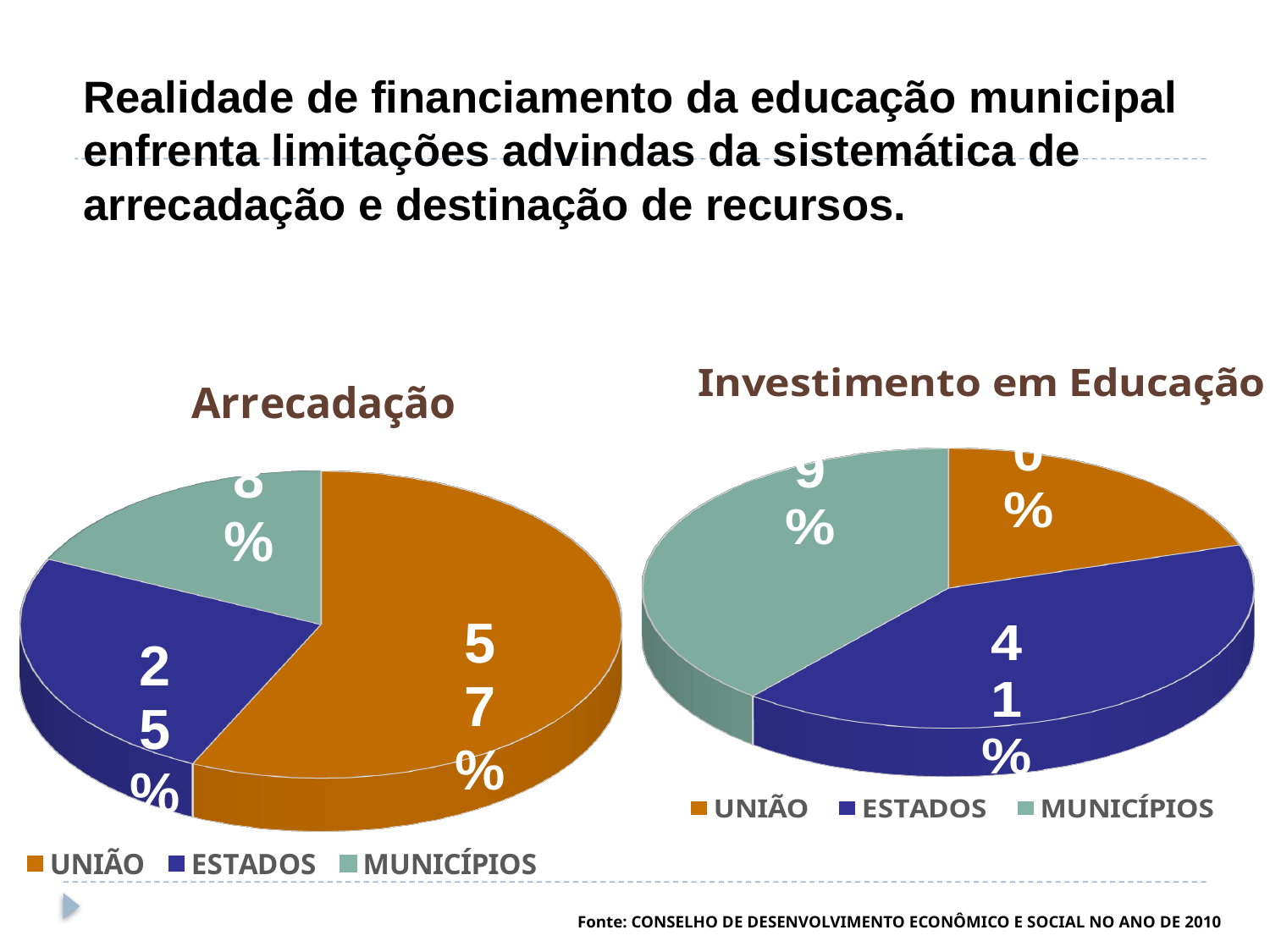
What is the title of the chart on the right side of the slide? Investimento em Educação What type of chart is the Arrecadação chart? Pie chart In the Investimento em Educação chart, which is larger, UNIÃO or ESTADOS? ESTADOS In the Arrecadação chart, what share does ESTADOS have? 25% In the Arrecadação chart, what share does UNIÃO have? 57% In the Investimento em Educação chart, which category has the smallest slice? UNIÃO In the Arrecadação chart, which category has the smallest slice? MUNICÍPIOS In the Arrecadação chart, what is the difference in percentage points between UNIÃO and ESTADOS? 32 In the Arrecadação chart, which category has the largest slice? UNIÃO In the Investimento em Educação chart, what share does ESTADOS have? 41% How many slices does the Arrecadação pie chart have? 3 How many entries does the legend of the Investimento em Educação chart list? 3